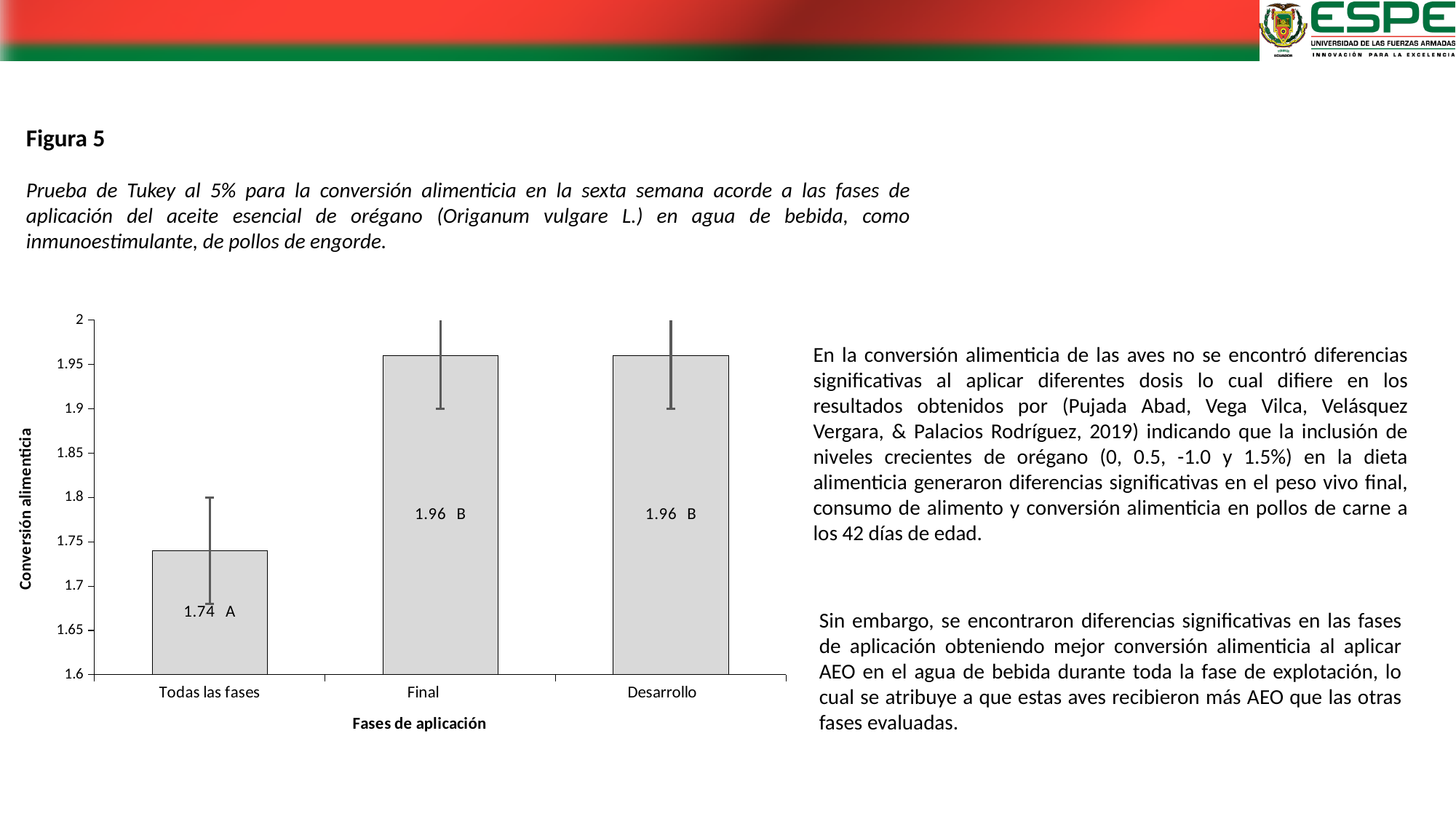
How many fases de aplicación are shown on the x axis? 3 Which Tukey group letter is shown next to the Todas las fases bar? A What kind of chart is shown on the slide? bar chart Is the value for Todas las fases greater or less than 1.8? less Is the value for Final greater or less than 1.9? greater What is the conversión alimenticia value for Final? 1.96 What is the difference between the conversión alimenticia for Final and for Todas las fases? 0.22 What is the conversión alimenticia value for Desarrollo? 1.96 What is the label of the y axis? Conversión alimenticia Which is larger, the value for Todas las fases or the value for Desarrollo? Desarrollo What is the conversión alimenticia value for Todas las fases? 1.74 Which fase de aplicación has the lowest conversión alimenticia? Todas las fases